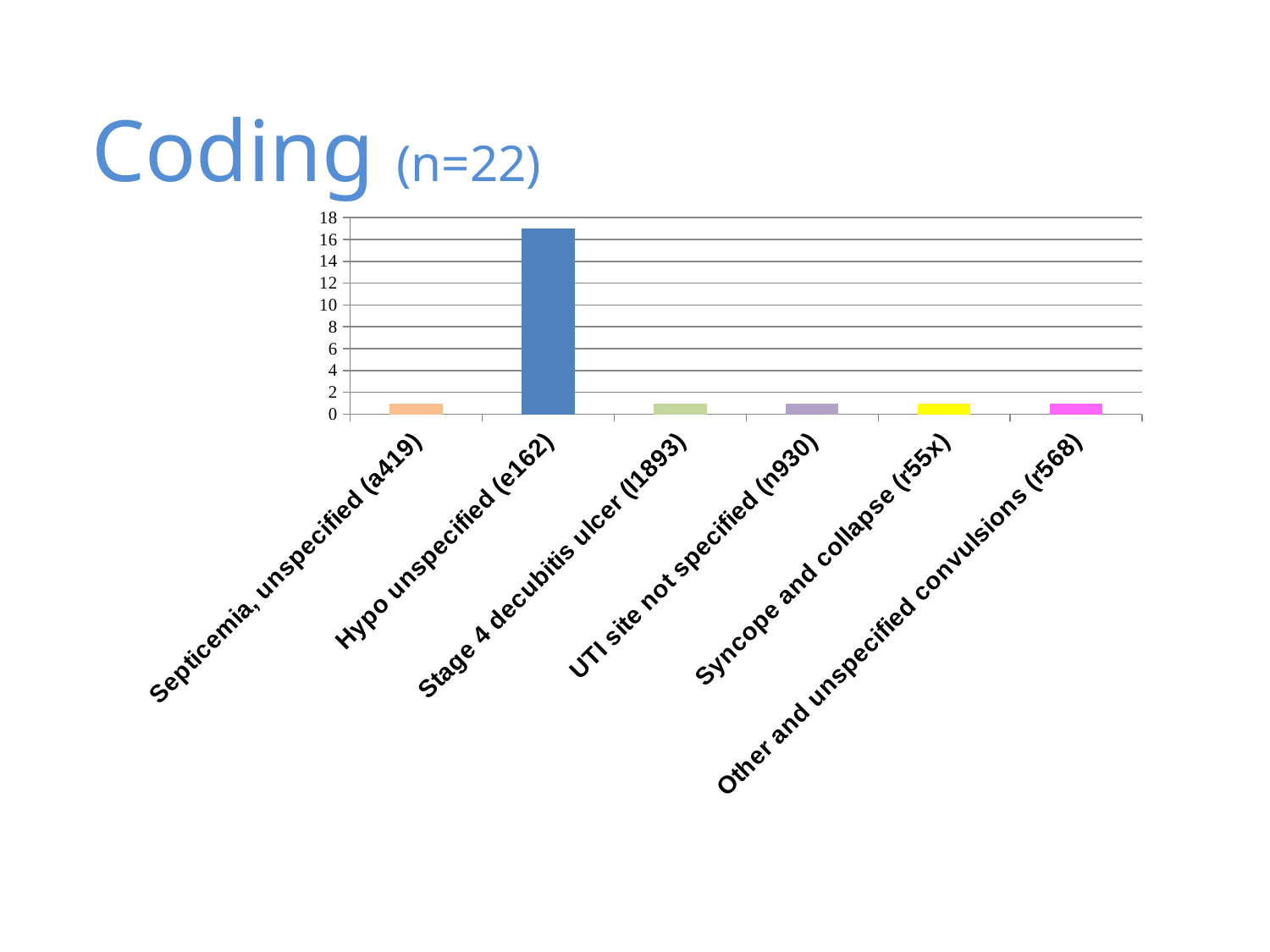
Is the value for Syncope and collapse (r55x) greater or less than 4? less How many categories are plotted on the chart? 6 Is the value for Hypo unspecified (e162) greater or less than 16? greater What kind of chart is shown on the slide? bar chart Is the value for Septicemia, unspecified (a419) greater or less than 2? less Which category has the highest value on the chart? Hypo unspecified (e162) What is the title of the slide containing the chart? Coding (n=22) Which is larger, the value for Stage 4 decubitis ulcer (l1893) or the value for Hypo unspecified (e162)? Hypo unspecified (e162) What colour is the bar for Hypo unspecified (e162)? blue Which is larger, the value for Hypo unspecified (e162) or the value for UTI site not specified (n930)? Hypo unspecified (e162)